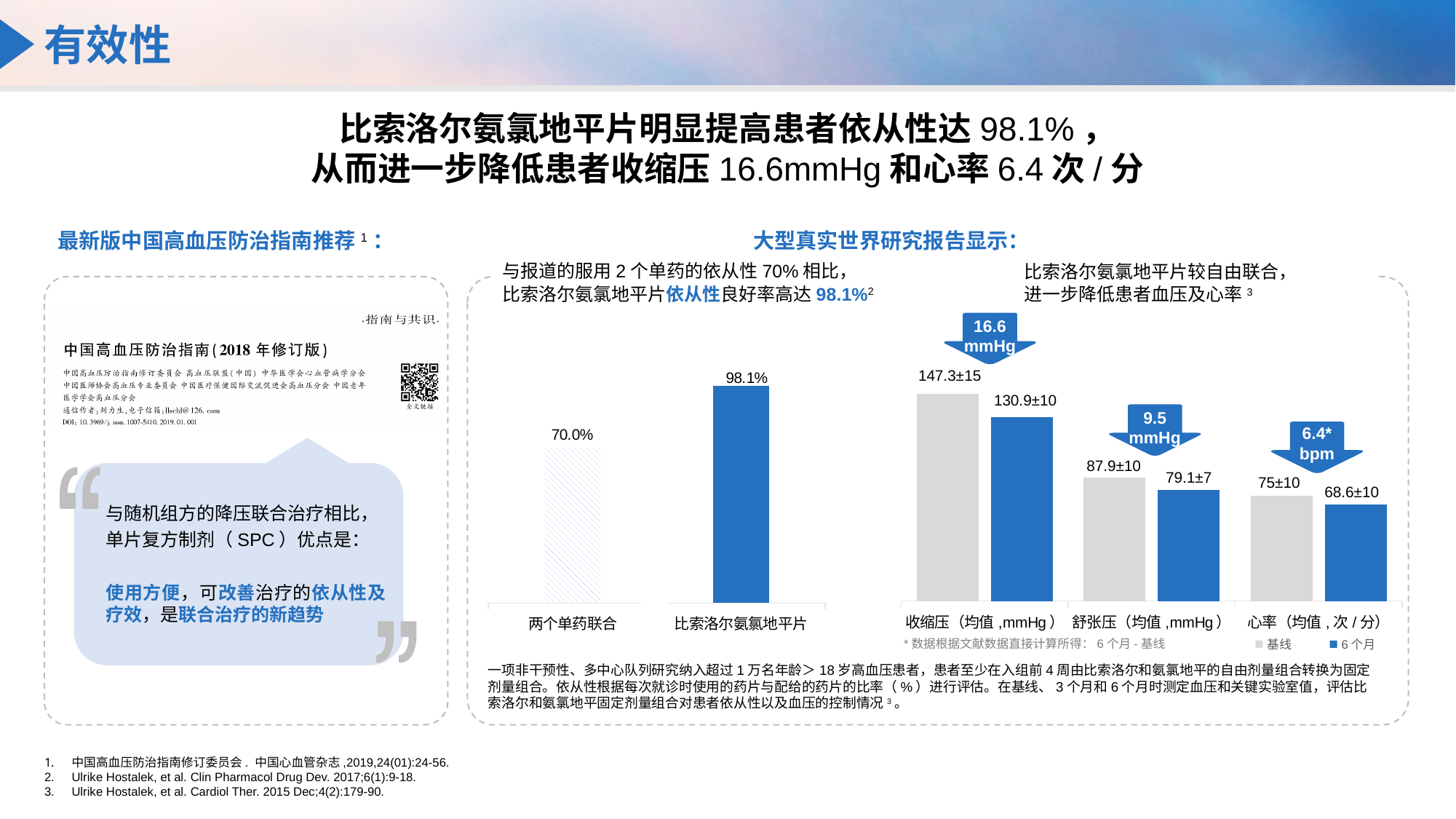
In the right chart (血压及心率), is the 基线 value for 心率 larger or smaller than the 6 个月 value? larger In the right chart (血压及心率), what is the 6 个月 value for 心率? 68.6±10 What kind of chart is the right chart (血压及心率)? bar chart In the right chart (血压及心率), what is the 6 个月 value for 舒张压? 79.1±7 In the left chart (依从性), which category has the higher value? 比索洛尔氨氯地平片 In the left chart (依从性), what is the value for 两个单药联合? 70.0% In the left chart (依从性), what is the value for 比索洛尔氨氯地平片? 98.1% In the left chart (依从性), how many categories are shown? 2 In the right chart (血压及心率), what reduction does the arrow above 收缩压 show? 16.6 mmHg In the right chart (血压及心率), how many series does the legend list? 2 In the right chart (血压及心率), what is the 基线 value for 收缩压? 147.3±15 In the left chart (依从性), what is the difference between the values for 比索洛尔氨氯地平片 and 两个单药联合? 28.1%